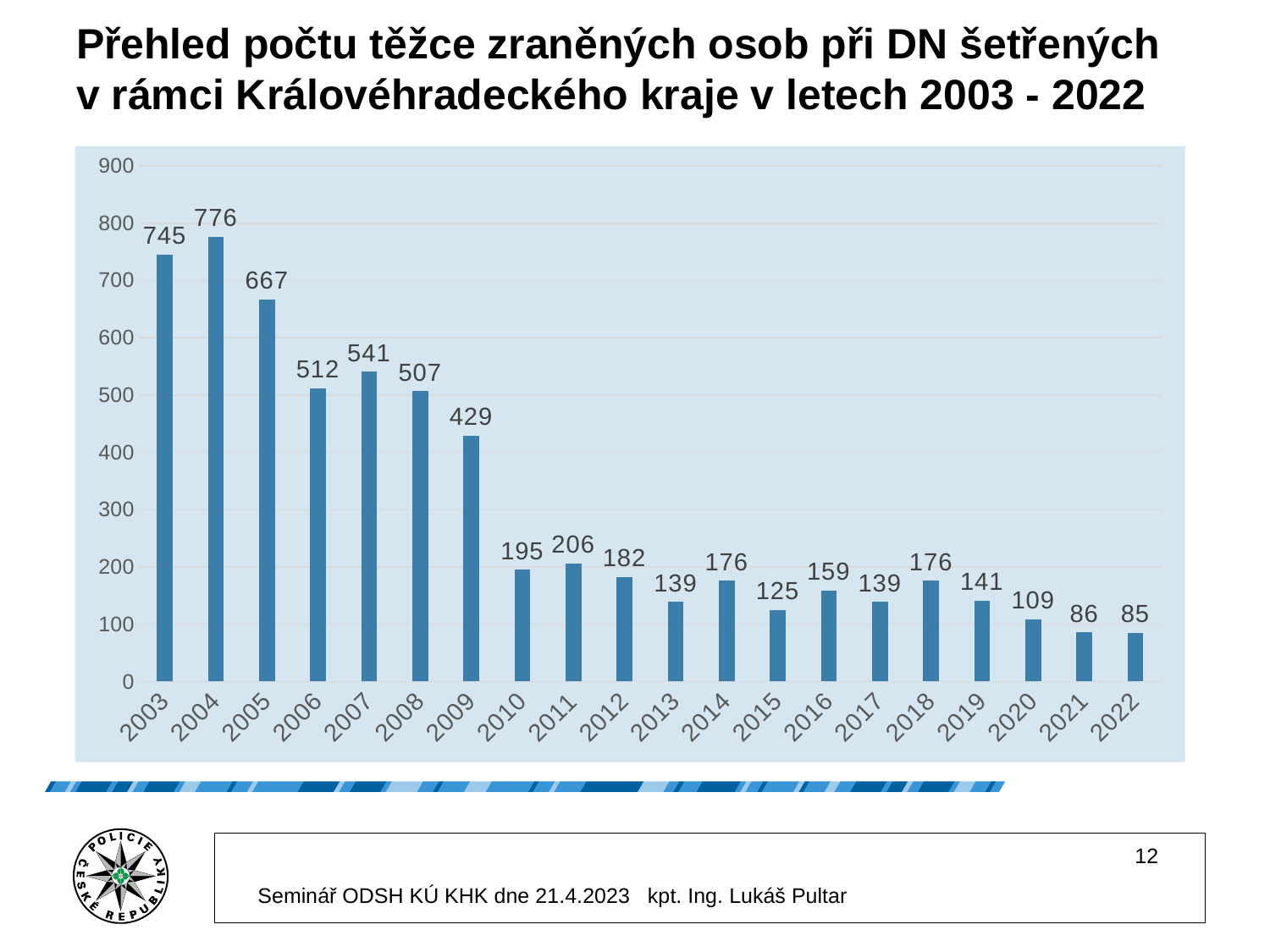
Is the value for 2006 greater or less than 500? greater What is the difference between the values for 2003 and 2004? 31 What is the difference between the values for 2009 and 2010? 234 Which year has the highest value? 2004 Do the values generally rise or fall from 2003 to 2022? fall What is the value for 2022? 85 Which is larger, the value for 2011 or the value for 2012? 2011 How many years are shown on the x axis? 20 What is the value for 2004? 776 Which year has the lowest value? 2022 What kind of chart is shown on the slide? bar chart What is the value for 2013? 139